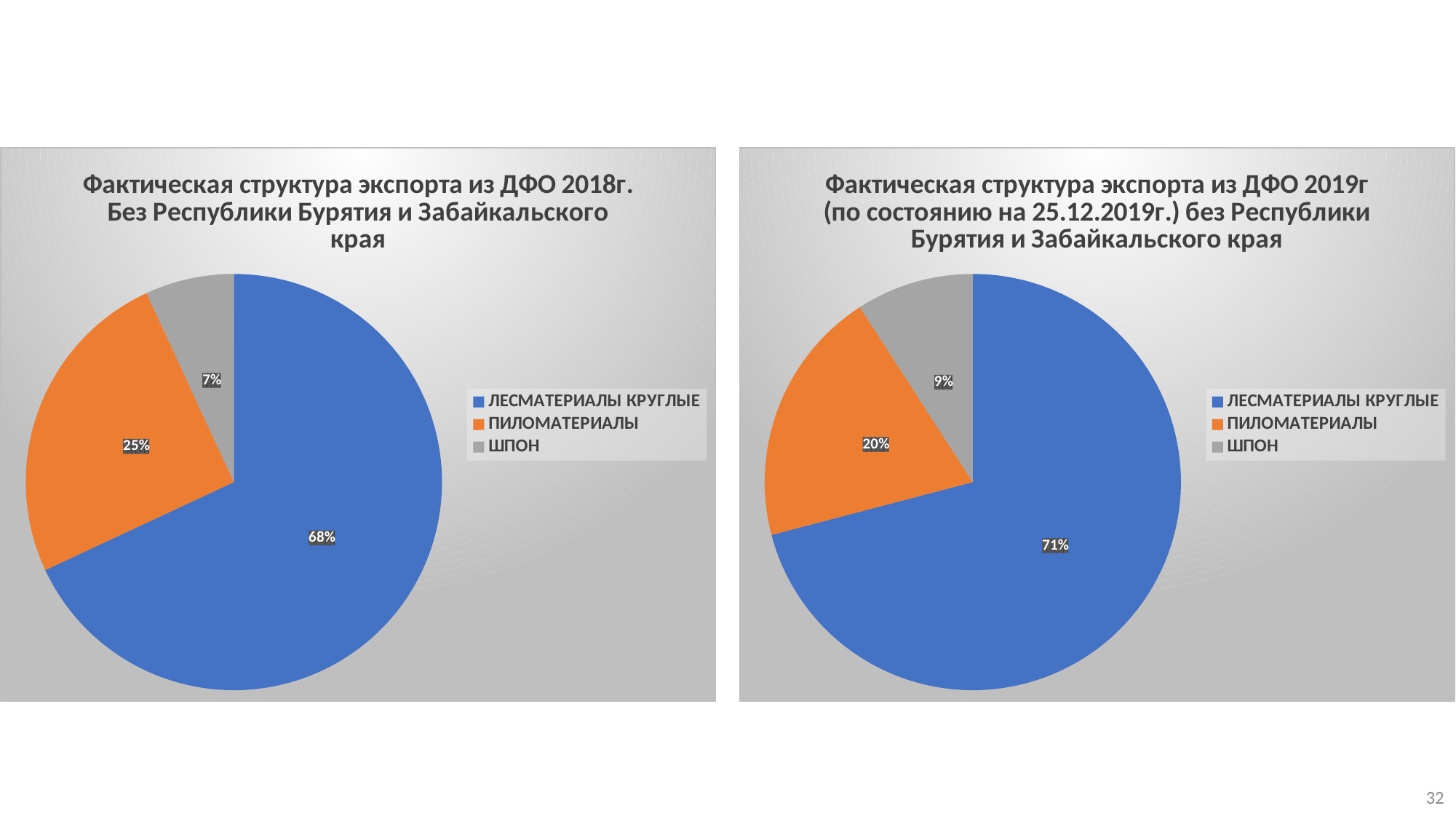
In the left chart (2018), what share of exports is ШПОН? 7% In the right chart (2019), which category has the smallest share? ШПОН In the left chart (2018), what share of exports is ПИЛОМАТЕРИАЛЫ? 25% In the left chart (2018), what share of exports is ЛЕСМАТЕРИАЛЫ КРУГЛЫЕ? 68% In the right chart (2019), what share of exports is ЛЕСМАТЕРИАЛЫ КРУГЛЫЕ? 71% Which chart shows a larger share for ПИЛОМАТЕРИАЛЫ, the left (2018) or the right (2019)? the left (2018) What type of chart is used on the left (2018)? pie chart In the left chart (2018), which category has the largest share? ЛЕСМАТЕРИАЛЫ КРУГЛЫЕ In the right chart (2019), what share of exports is ШПОН? 9% In the right chart (2019), what is the difference in percentage points between ЛЕСМАТЕРИАЛЫ КРУГЛЫЕ and ПИЛОМАТЕРИАЛЫ? 51 In the right chart (2019), what share of exports is ПИЛОМАТЕРИАЛЫ? 20% How many categories does the legend of the right chart (2019) list? 3